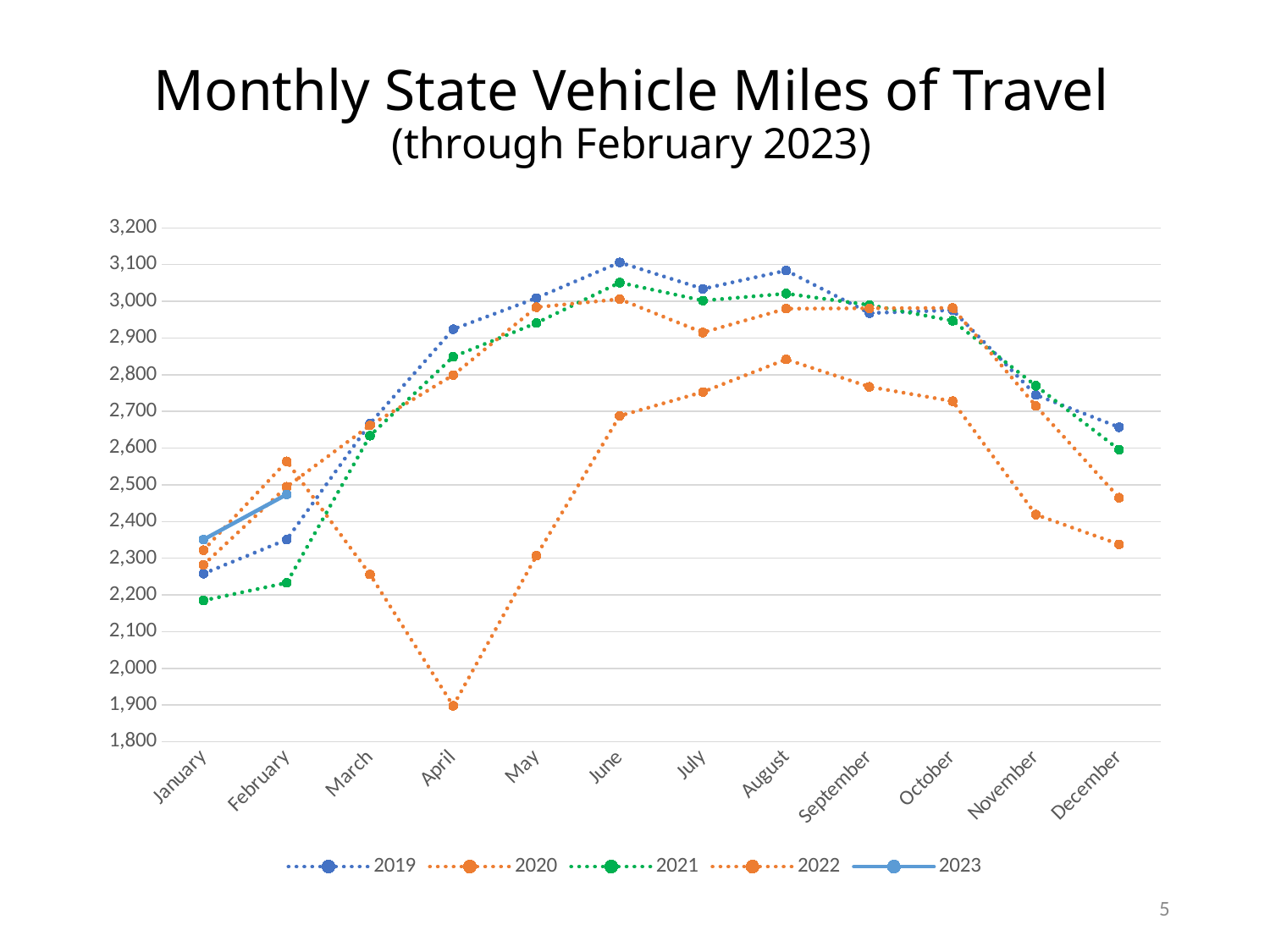
Is the value for 2019 in June greater or less than 3,000? greater Which series has the highest value in June? 2019 In January, which is larger: the value for 2019 or the value for 2021? 2019 How many months are shown along the x axis? 12 What kind of chart is shown on the slide? Line chart Is the value for 2019 in December greater or less than 2,600? greater What is the title of the chart? Monthly State Vehicle Miles of Travel (through February 2023) Which month has the lowest plotted value on the chart? April How many series does the legend list? 5 Does the 2023 series rise or fall from January to February? rise Is the value for 2023 in February greater or less than 2,400? greater